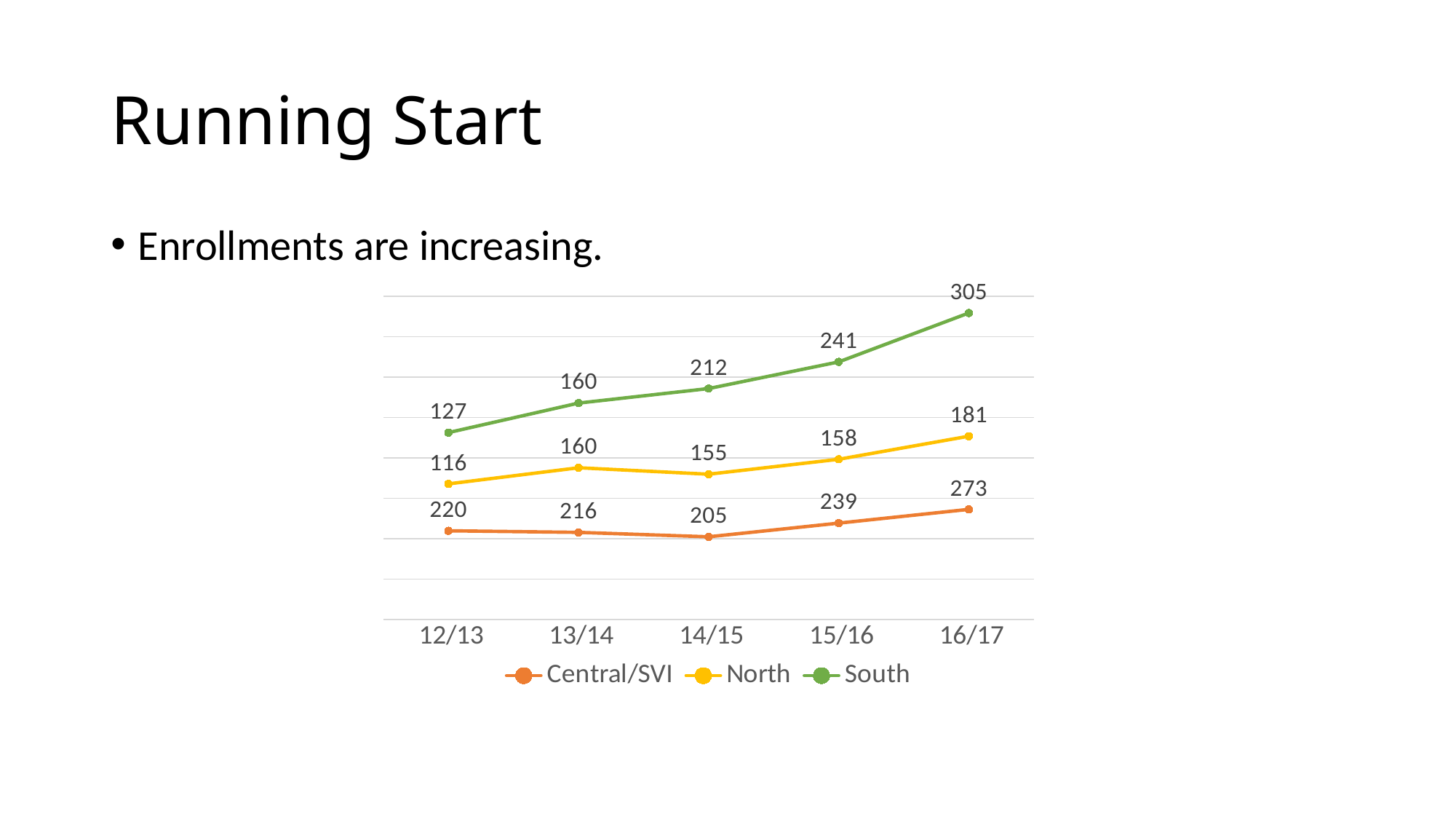
Does the South series rise or fall from 12/13 to 16/17? rise How many years are shown on the x axis? 5 Which is larger, the North value in 15/16 or the North value in 14/15? 15/16 What is the value for South in 16/17? 305 In which year is the Central/SVI value lowest? 14/15 How many series does the legend list? 3 What is the value for Central/SVI in 14/15? 205 What is the difference between the South values in 16/17 and 12/13? 178 What kind of chart is shown on the slide? line chart What is the value for North in 12/13? 116 What is the value for Central/SVI in 16/17? 273 In which year is the South value highest? 16/17